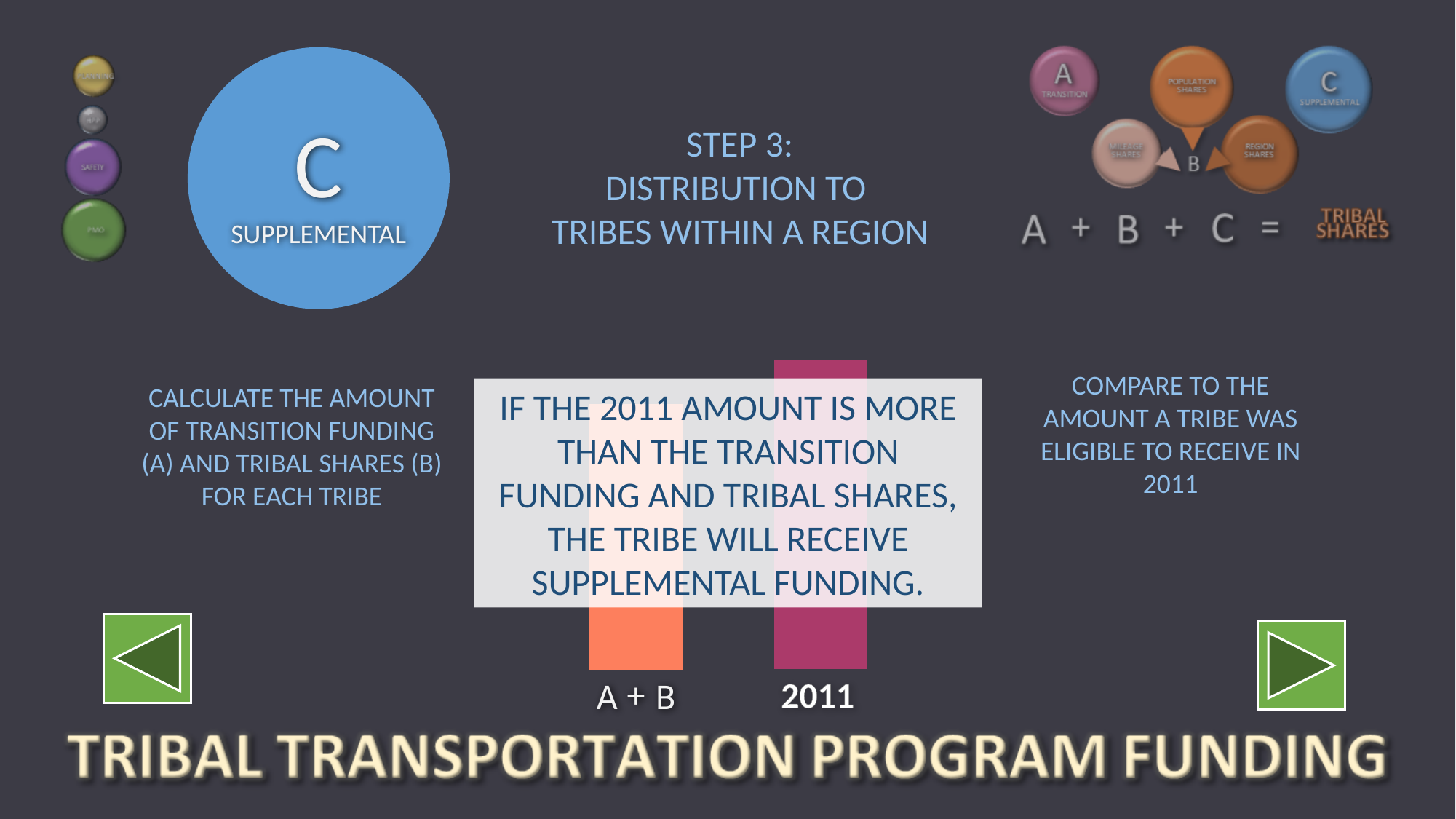
What are the labels of the two bars in the chart? A + B and 2011 Which category has the highest bar in the chart? 2011 What colour is the bar labelled 2011? magenta How many bars does the chart in the middle of the slide have? 2 Which bar in the chart is taller, A + B or 2011? 2011 Is the bar for A + B shorter or taller than the bar for 2011? shorter Which category has the lowest bar in the chart? A + B What kind of chart is shown in the middle of the slide? bar chart